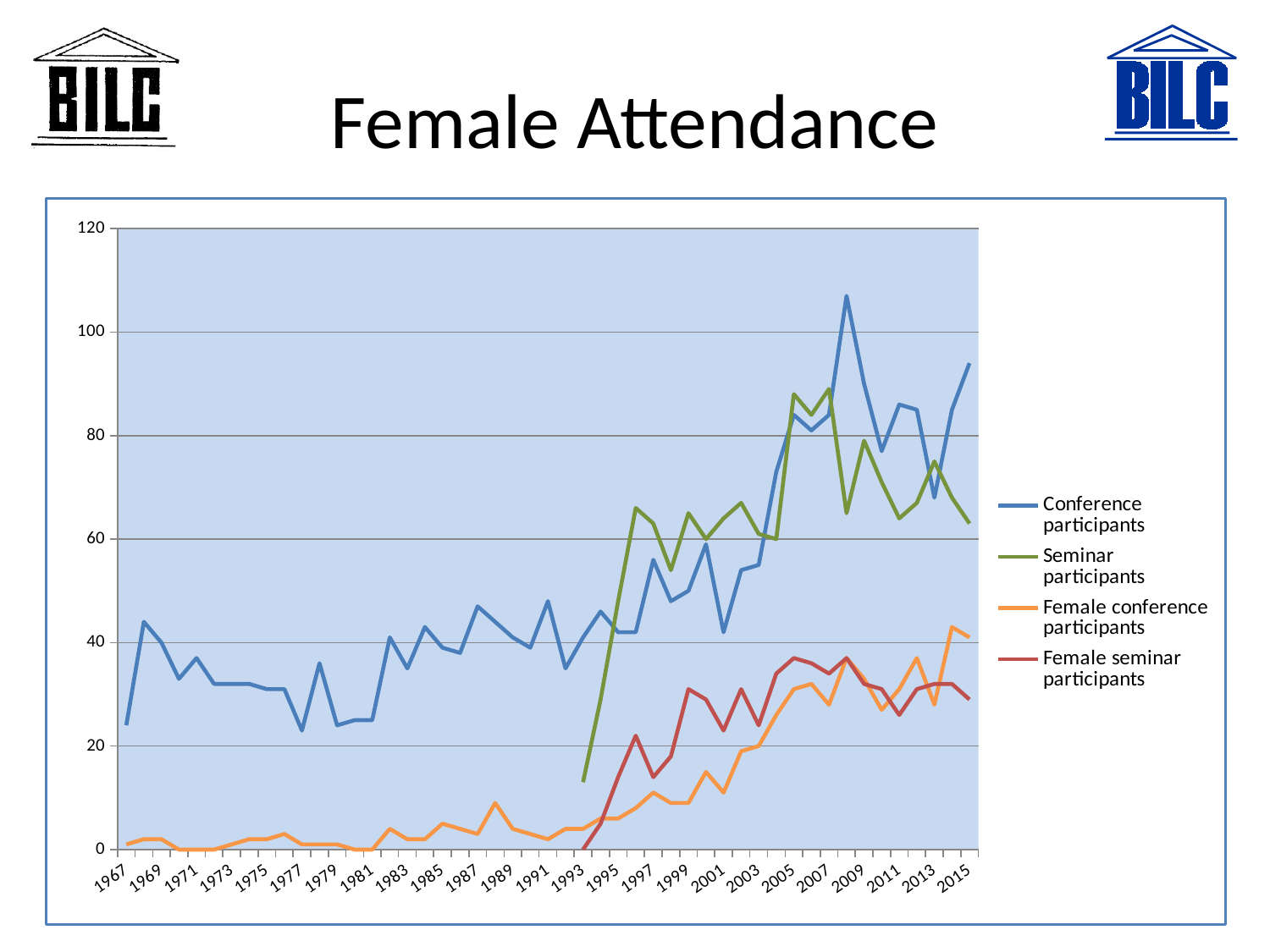
In 2015, which is larger: Conference participants or Seminar participants? Conference participants Which series reaches the highest value anywhere on the chart? Conference participants How many series does the legend list? 4 Which series is drawn in orange? Female conference participants Overall, do Female conference participants rise or fall from 1967 to 2015? Rise Is the value for Conference participants in 1977 greater or less than 40? less Is the value for Female seminar participants in 2005 greater or less than 20? greater What kind of chart is shown on the slide? Line chart Is the value for Seminar participants in 1993 greater or less than 20? less In 1997, which is larger: Seminar participants or Conference participants? Seminar participants What is the title of the slide's chart? Female Attendance